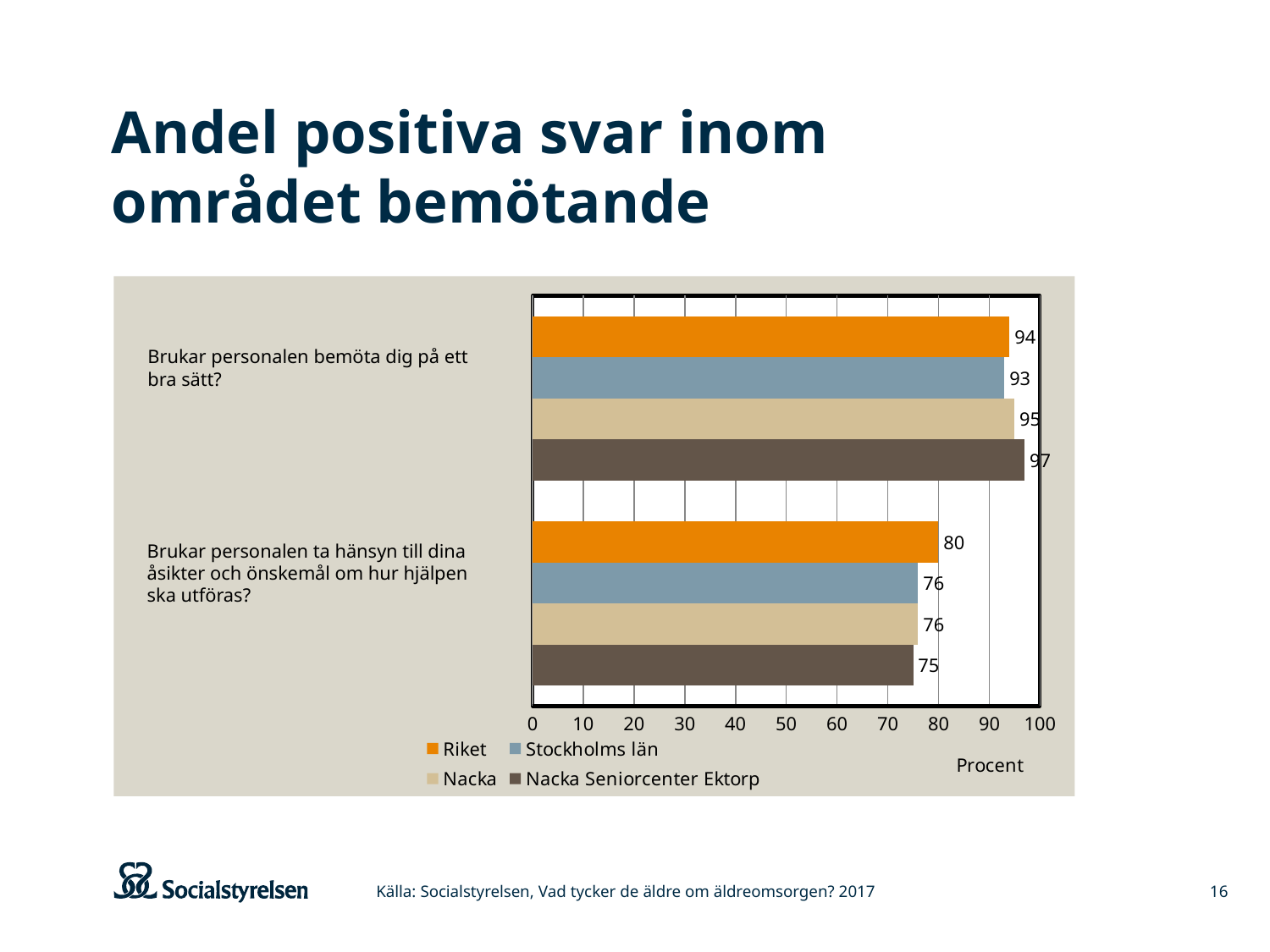
Which is larger for Nacka: the value on "Brukar personalen bemöta dig på ett bra sätt?" or on "Brukar personalen ta hänsyn till dina åsikter och önskemål om hur hjälpen ska utföras?"? Brukar personalen bemöta dig på ett bra sätt? What kind of chart is shown on the slide? Bar chart Which series has the highest value on the question "Brukar personalen bemöta dig på ett bra sätt?"? Nacka Seniorcenter Ektorp How many questions (categories) are shown on the chart? 2 What is the value for Nacka Seniorcenter Ektorp on the question "Brukar personalen ta hänsyn till dina åsikter och önskemål om hur hjälpen ska utföras?"? 75 Which series has the lowest value on the question "Brukar personalen ta hänsyn till dina åsikter och önskemål om hur hjälpen ska utföras?"? Nacka Seniorcenter Ektorp What is the value for Stockholms län on the question "Brukar personalen bemöta dig på ett bra sätt?"? 93 What is the label on the horizontal axis of the chart? Procent What is the difference between the Riket value and the Nacka Seniorcenter Ektorp value on the question "Brukar personalen ta hänsyn till dina åsikter och önskemål om hur hjälpen ska utföras?"? 5 Is the value for Riket on "Brukar personalen ta hänsyn till dina åsikter och önskemål om hur hjälpen ska utföras?" greater or less than 70? greater What is the value for Riket on the question "Brukar personalen bemöta dig på ett bra sätt?"? 94 How many series does the legend list? 4